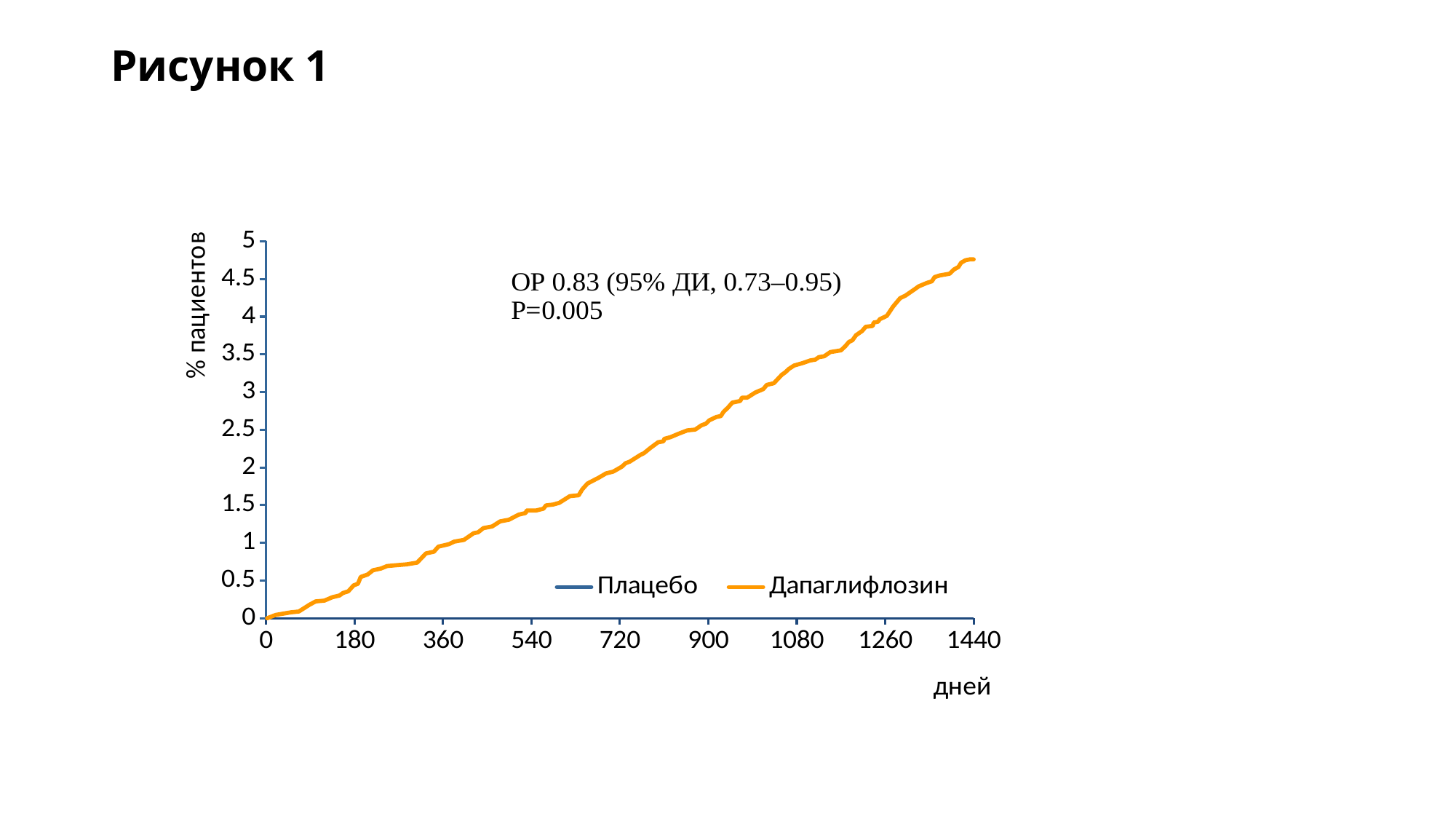
What kind of chart is shown on the slide? line chart How many series does the legend list? 2 Does the Дапаглифлозин line rise or fall as the number of days increases? rises Is the value for Дапаглифлозин at 180 days greater or less than 0.5? less Is the value for Дапаглифлозин at 1440 days greater or less than 4.5? greater Is the value for Дапаглифлозин at 1080 days greater or less than 3? greater What is the label of the y axis? % пациентов At which number of days does the Дапаглифлозин line reach its highest value? 1440 What hazard ratio (ОР) is printed on the chart? 0.83